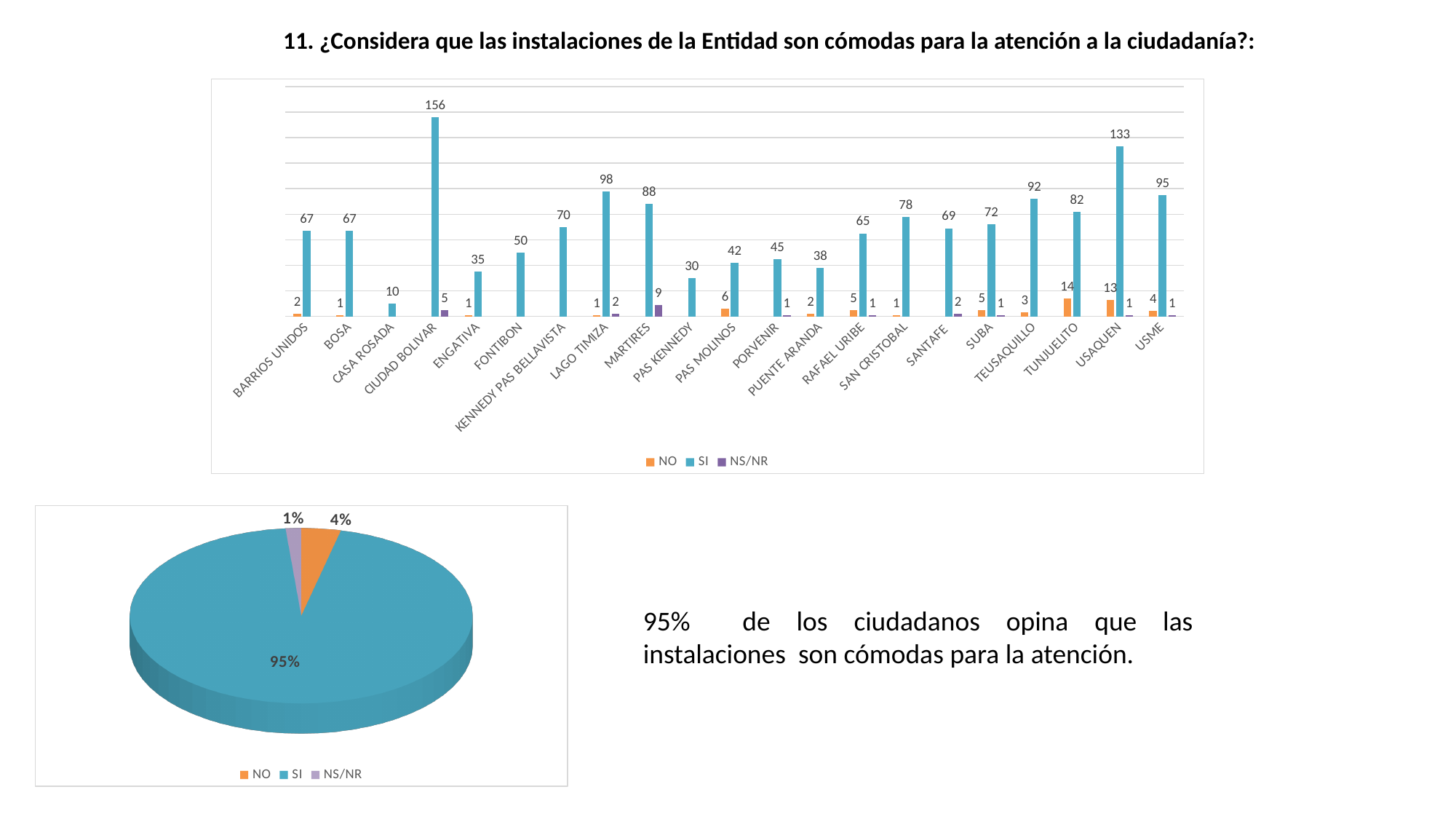
In the bar chart, what is the NO value for TUNJUELITO? 14 How many series does the legend of the bar chart list? 3 How many categories are shown on the x axis of the bar chart? 21 In the bar chart, what is the SI value for CIUDAD BOLIVAR? 156 In the bar chart, what is the difference between the SI values for USAQUEN and USME? 38 In the bar chart, which category has the highest SI value? CIUDAD BOLIVAR In the pie chart, what share does the SI slice represent? 95% In the bar chart, which category has the lowest SI value? CASA ROSADA What kind of chart is the chart at the bottom left of the slide? Pie chart In the bar chart, which has a larger SI value, LAGO TIMIZA or MARTIRES? LAGO TIMIZA In the pie chart, what share does the NO slice represent? 4% In the bar chart, what is the NS/NR value for MARTIRES? 9